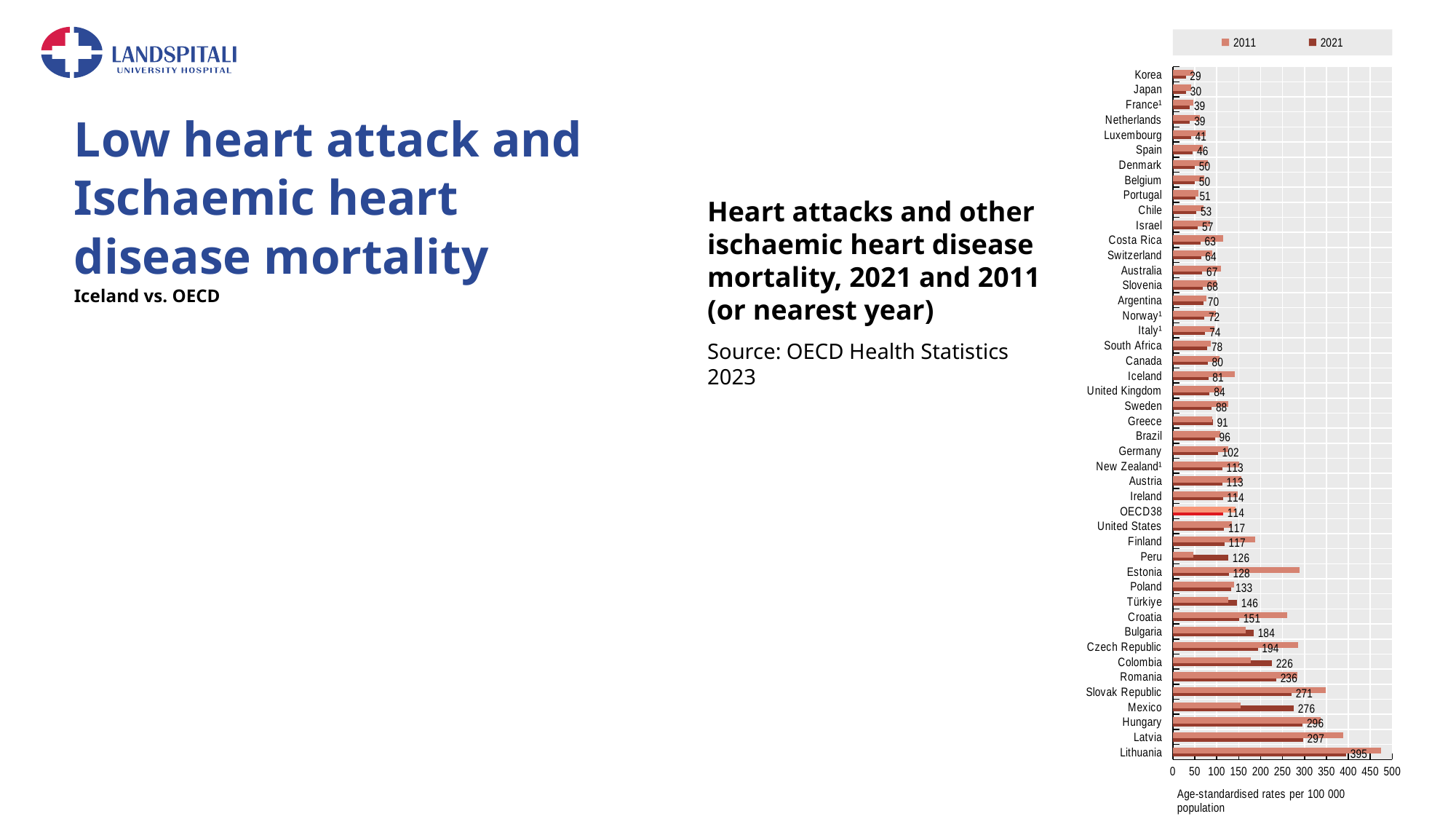
What is the difference between the 2021 values for Lithuania and Korea? 366 Is the 2011 value for Lithuania greater or less than 450? greater What kind of chart is shown on the slide? Bar chart What is the difference between the 2021 values for OECD38 and Iceland? 33 Which has a higher 2021 value, Latvia or Hungary? Latvia What is the 2021 value shown for Lithuania? 395 Is the 2011 value for Iceland greater or less than 100? greater What is the 2021 heart disease mortality rate shown for Iceland? 81 What is the 2021 value shown for OECD38? 114 How many series does the legend list? 2 Which country has the lowest 2021 mortality rate in the chart? Korea Which country has the highest 2021 mortality rate in the chart? Lithuania